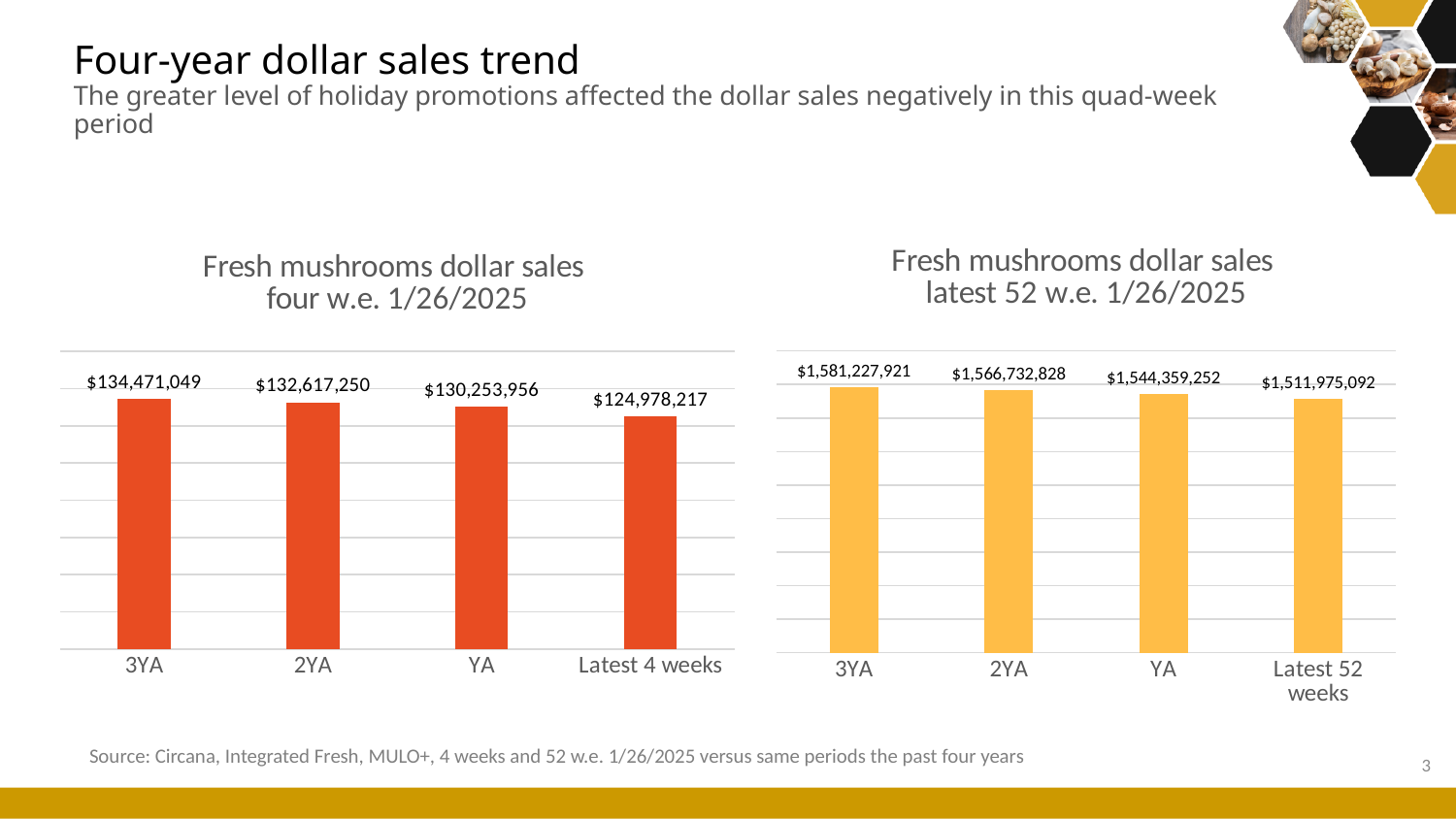
In the 'Fresh mushrooms dollar sales four w.e. 1/26/2025' chart, what is the value for 3YA? $134,471,049 In the 'Fresh mushrooms dollar sales latest 52 w.e. 1/26/2025' chart, what is the value for Latest 52 weeks? $1,511,975,092 How many periods are shown on the x axis of the 'Fresh mushrooms dollar sales latest 52 w.e. 1/26/2025' chart? 4 What kind of chart is the 'Fresh mushrooms dollar sales four w.e. 1/26/2025' chart? Bar chart In the 'Fresh mushrooms dollar sales latest 52 w.e. 1/26/2025' chart, which period has the lowest value? Latest 52 weeks In the 'Fresh mushrooms dollar sales four w.e. 1/26/2025' chart, which is larger, the value for 2YA or the value for YA? 2YA In the 'Fresh mushrooms dollar sales four w.e. 1/26/2025' chart, what is the value for Latest 4 weeks? $124,978,217 In the 'Fresh mushrooms dollar sales four w.e. 1/26/2025' chart, which period has the highest value? 3YA In the 'Fresh mushrooms dollar sales latest 52 w.e. 1/26/2025' chart, what is the value for YA? $1,544,359,252 In the 'Fresh mushrooms dollar sales latest 52 w.e. 1/26/2025' chart, what is the difference between the 2YA value and the YA value? $22,373,576 In the 'Fresh mushrooms dollar sales latest 52 w.e. 1/26/2025' chart, do the values rise or fall from 3YA to Latest 52 weeks? Fall In the 'Fresh mushrooms dollar sales four w.e. 1/26/2025' chart, what is the difference between the 3YA value and the Latest 4 weeks value? $9,492,832